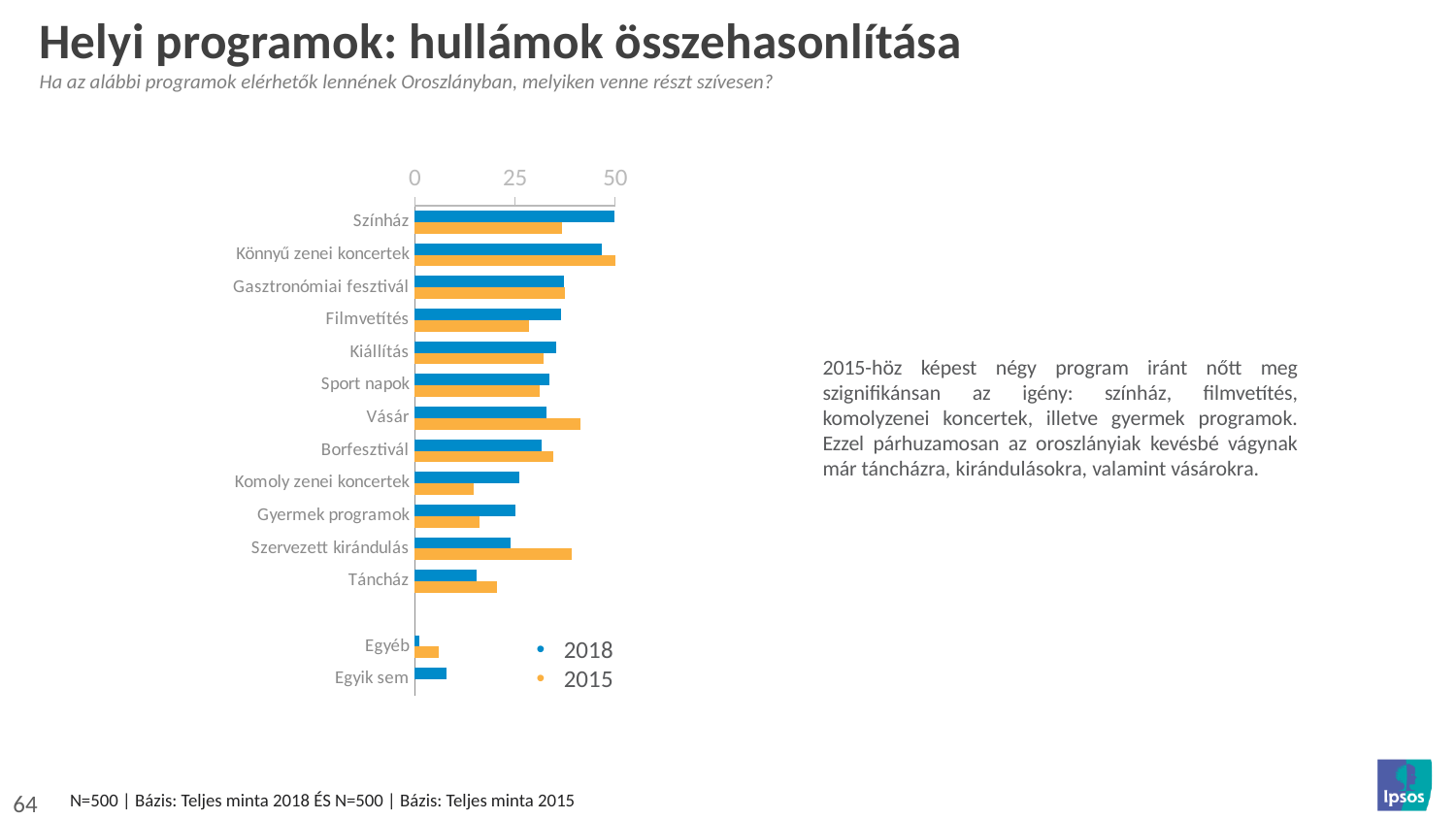
For Színház, which series has the larger value, 2018 or 2015? 2018 Which colour represents the 2015 series in the chart? orange For Szervezett kirándulás, which series has the larger value, 2018 or 2015? 2015 Which category has the lowest value for the 2018 series? Egyéb How many categories are shown on the chart? 14 Is the 2018 value for Táncház greater or less than 25? less How many series does the legend list? 2 Which category has the highest value for the 2015 series? Könnyű zenei koncertek What kind of chart is shown on the slide? bar chart For Vásár, which series has the larger value, 2018 or 2015? 2015 Is the 2015 value for Szervezett kirándulás greater or less than 25? greater Which category has the highest value for the 2018 series? Színház